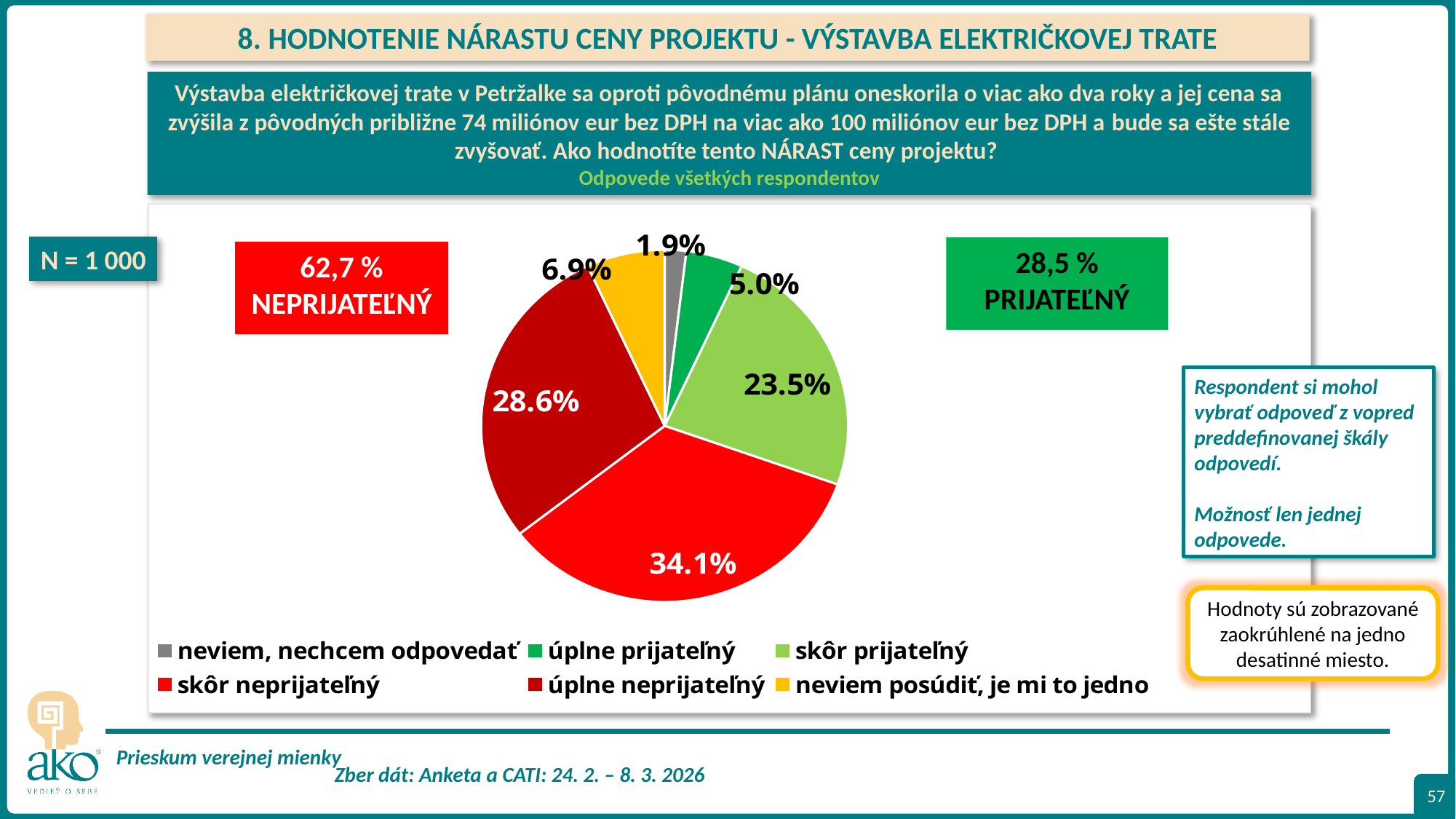
What percentage of respondents answered "neviem posúdiť, je mi to jedno"? 6.9% What is the difference in percentage points between "skôr neprijateľný" and "úplne neprijateľný"? 5.5 Which answer category has the smallest share of the pie? neviem, nechcem odpovedať What percentage of respondents answered "úplne neprijateľný"? 28.6% What percentage of respondents answered "skôr neprijateľný"? 34.1% How many categories does the pie chart legend list? 6 What colour is the slice for "úplne neprijateľný"? dark red Which answer category has the largest share of the pie? skôr neprijateľný What kind of chart is shown on the slide? pie chart What percentage of respondents answered "skôr prijateľný"? 23.5% What percentage of respondents answered "neviem, nechcem odpovedať"? 1.9% Which is larger: the share for "úplne prijateľný" or the share for "neviem posúdiť, je mi to jedno"? neviem posúdiť, je mi to jedno